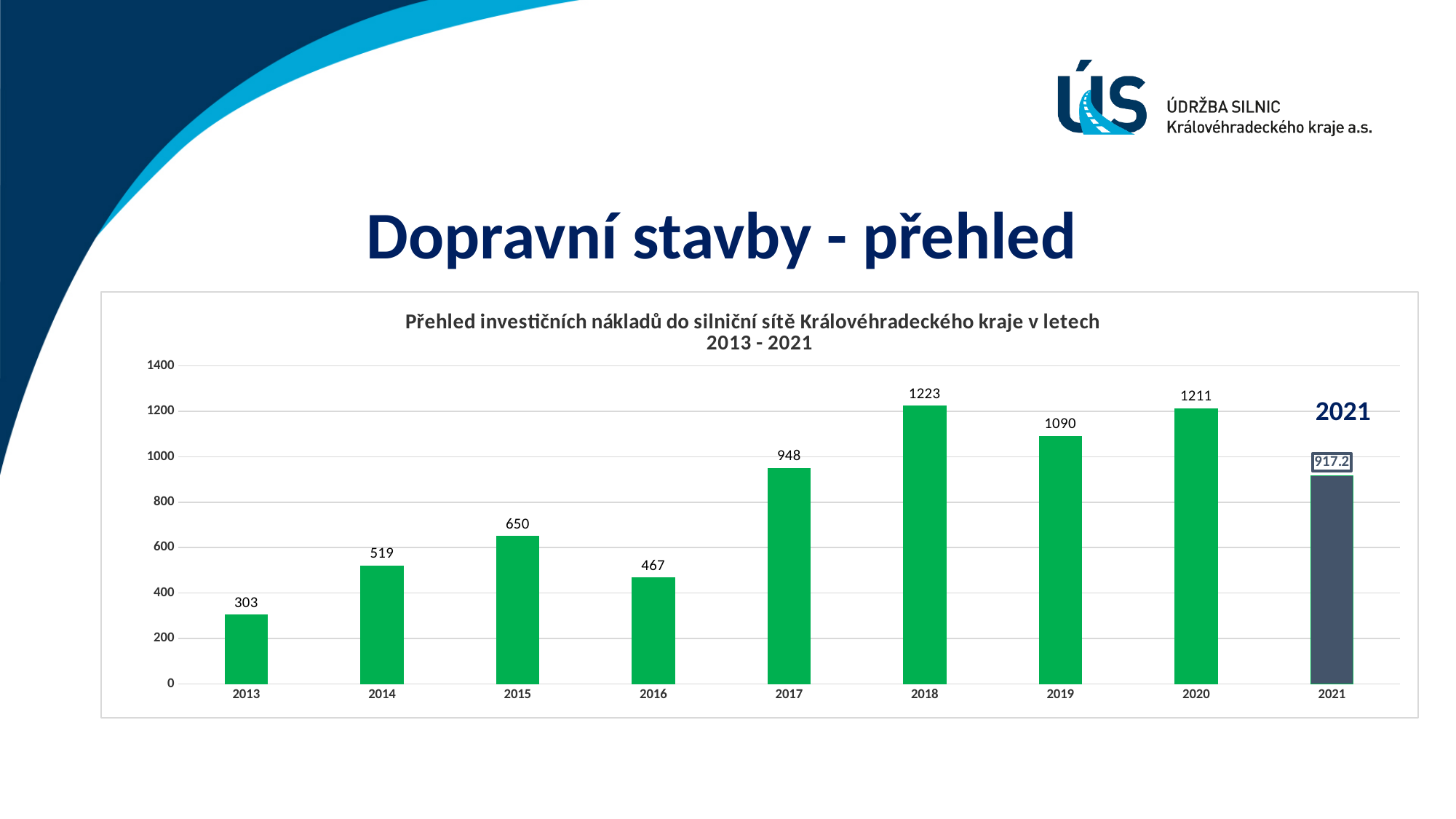
Which bar is shown in a different colour from the others? 2021 Which year has the lowest value? 2013 What kind of chart is shown on the slide? bar chart Is the value for 2017 greater or less than 1000? less How many years are shown on the x axis? 9 What is the value for 2018? 1223 Do the values rise or fall from 2013 to 2015? rise What is the difference between the values for 2020 and 2019? 121 Which is larger, the value for 2015 or the value for 2016? 2015 What is the value for 2021? 917.2 What is the value for 2013? 303 Which year has the highest value? 2018